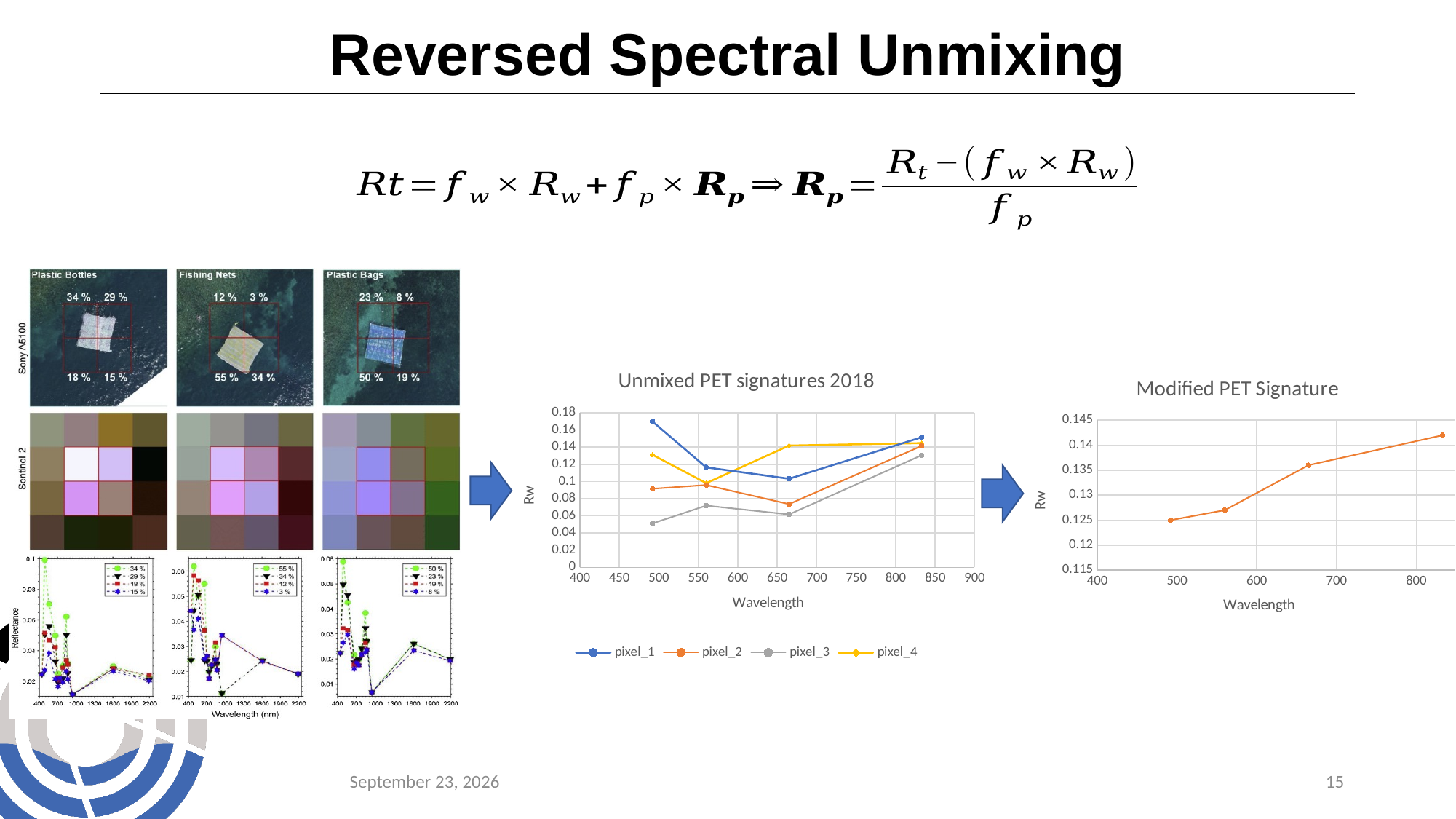
In the 'Unmixed PET signatures 2018' chart, which series has the highest value at the leftmost wavelength? pixel_1 In the 'Modified PET Signature' chart, is the value at the rightmost wavelength greater or less than 0.135? greater How many series does the legend of the 'Unmixed PET signatures 2018' chart list? 4 How many data points are plotted in the 'Modified PET Signature' chart? 4 What are the legend entries of the 'Unmixed PET signatures 2018' chart? pixel_1, pixel_2, pixel_3, pixel_4 What kind of chart is the 'Unmixed PET signatures 2018' chart? line chart In the 'Unmixed PET signatures 2018' chart, is the first (leftmost) value of pixel_3 greater or less than 0.06? less In the 'Unmixed PET signatures 2018' chart, which series has the lowest value at the rightmost wavelength? pixel_3 What is the y-axis label of the 'Unmixed PET signatures 2018' chart? Rw Do the values in the 'Modified PET Signature' chart rise or fall as wavelength increases? rise In the 'Unmixed PET signatures 2018' chart, at the wavelength around 665, which series is higher: pixel_4 or pixel_3? pixel_4 In the 'Unmixed PET signatures 2018' chart, is the first (leftmost) value of pixel_1 greater or less than 0.16? greater